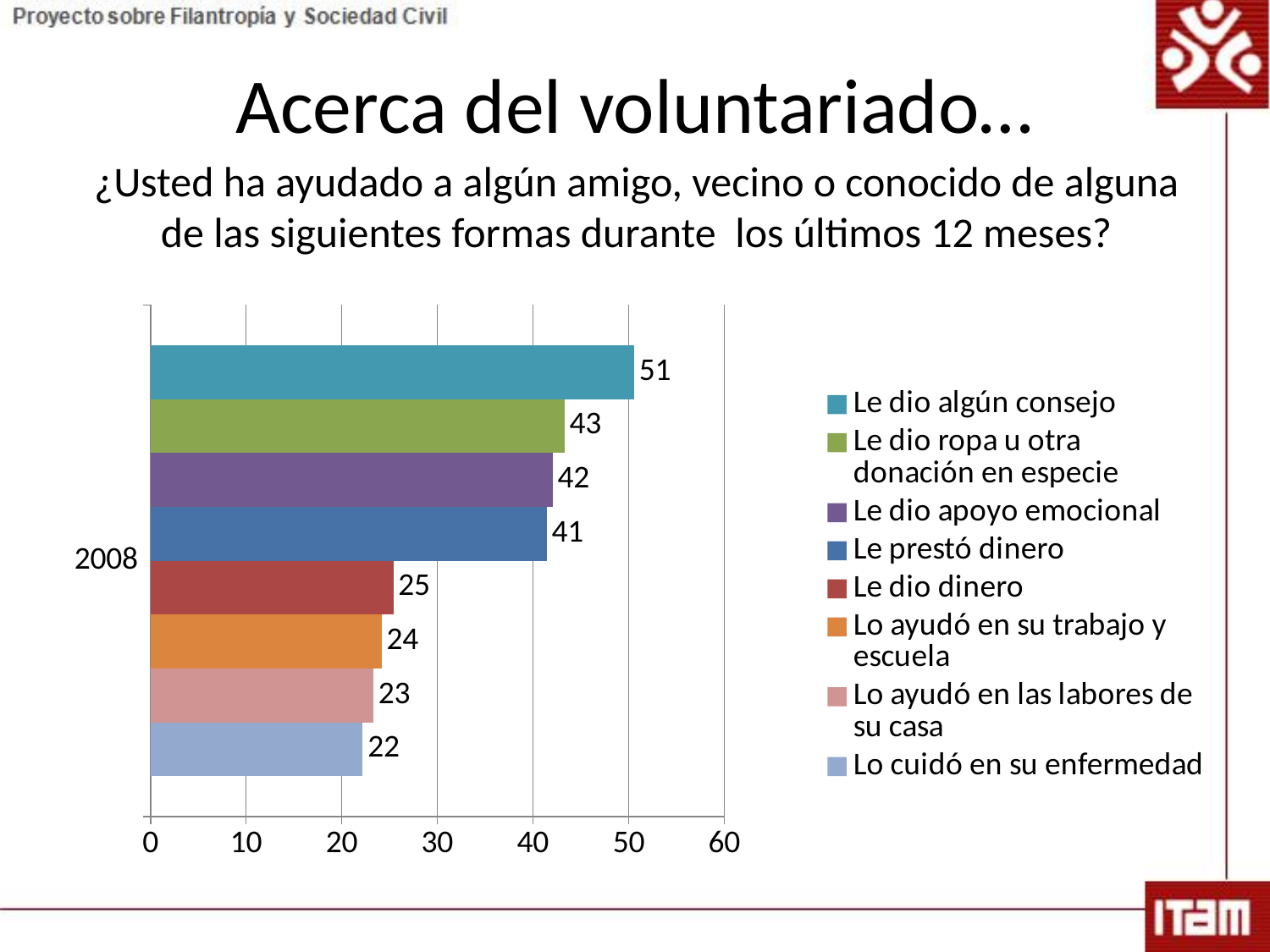
Which series has the lowest value? Lo cuidó en su enfermedad Which series has the highest value? Le dio algún consejo What is the maximum value shown on the horizontal axis? 60 What kind of chart is shown on the slide? bar chart What value is shown for "Le dio algún consejo"? 51 What value is shown for "Lo ayudó en las labores de su casa"? 23 What is the difference between the values for "Le dio algún consejo" and "Le dio dinero"? 26 What is the category label shown on the vertical axis of the chart? 2008 What value is shown for "Le dio apoyo emocional"? 42 Which is larger: the value for "Le dio ropa u otra donación en especie" or the value for "Lo ayudó en su trabajo y escuela"? Le dio ropa u otra donación en especie What value is shown for "Le prestó dinero"? 41 How many series does the legend list? 8